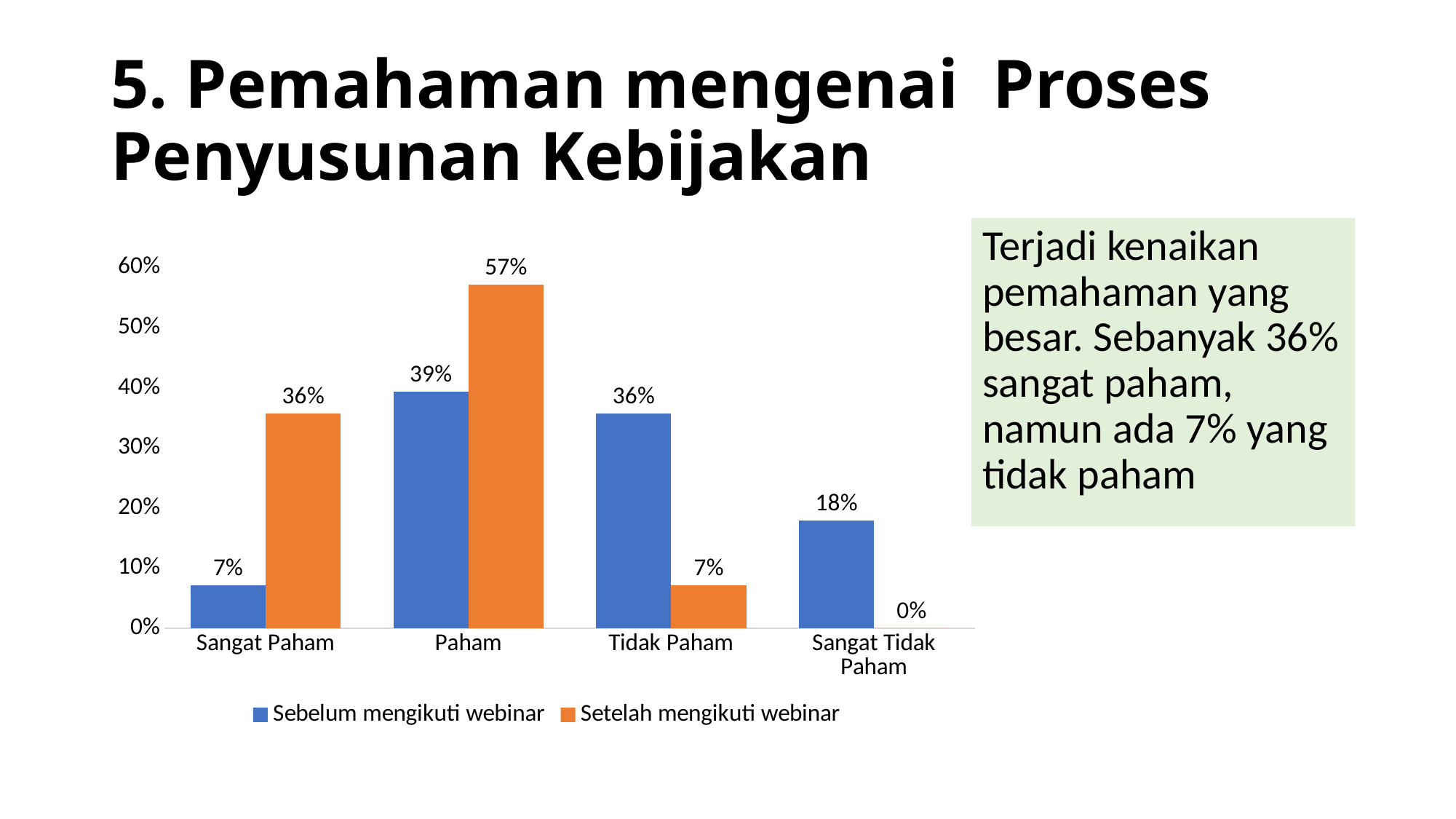
What is the difference between the Setelah mengikuti webinar and Sebelum mengikuti webinar values for Sangat Paham? 29% Which category has the lowest value in the Sebelum mengikuti webinar series? Sangat Paham What is the value for Tidak Paham in the Sebelum mengikuti webinar series? 36% How many categories are shown on the x axis? 4 Which colour represents the Setelah mengikuti webinar series? Orange What is the value for Sangat Tidak Paham in the Setelah mengikuti webinar series? 0% What kind of chart is shown on the slide? Bar chart What is the value for Paham in the Setelah mengikuti webinar series? 57% For Tidak Paham, which series has the larger value, Sebelum mengikuti webinar or Setelah mengikuti webinar? Sebelum mengikuti webinar Which category has the highest value in the Setelah mengikuti webinar series? Paham What is the value for Sangat Paham in the Sebelum mengikuti webinar series? 7% How many series does the legend list? 2